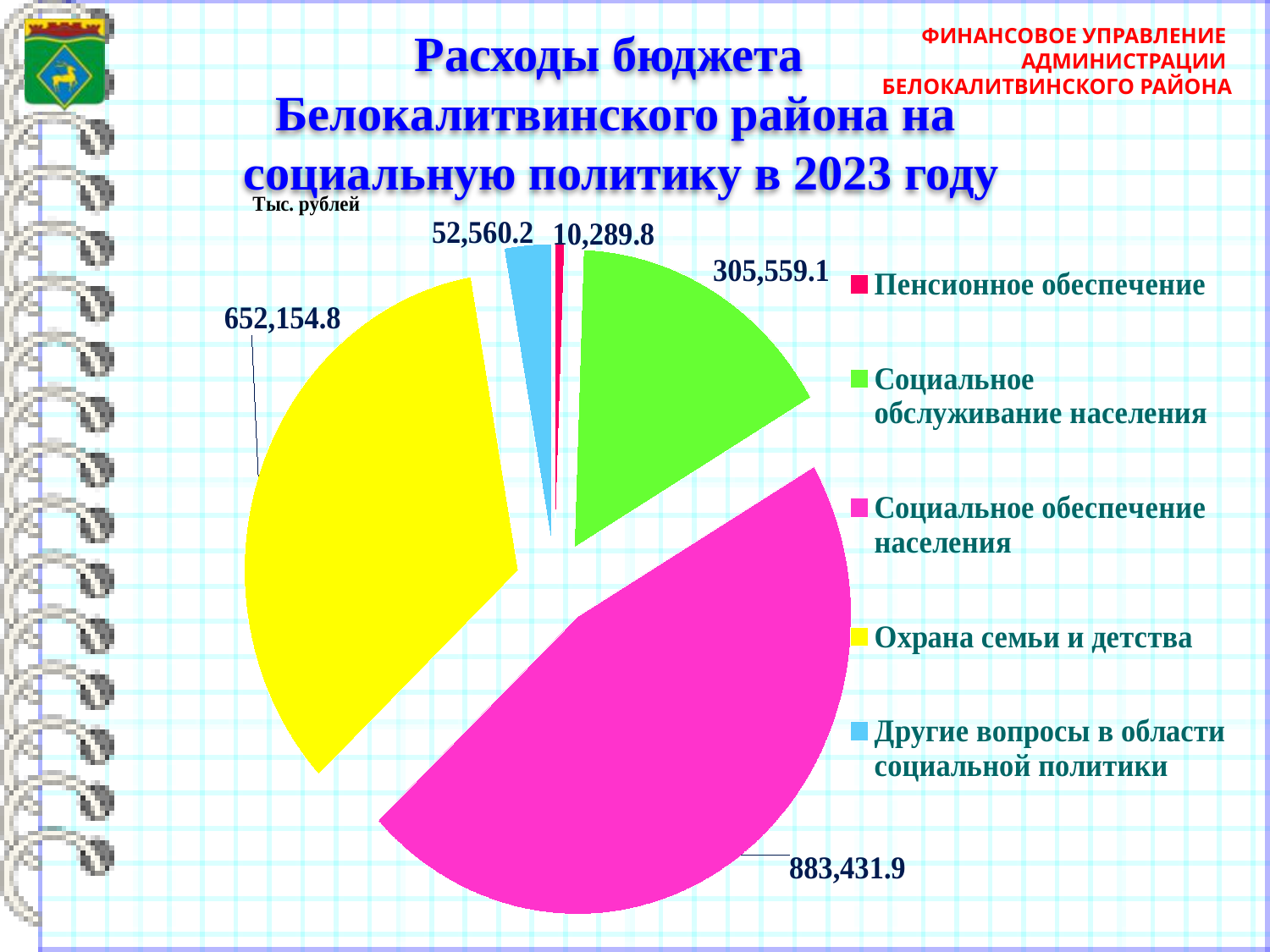
What is the value for Социальное обеспечение населения? 883,431.9 Which is larger: Социальное обслуживание населения or Другие вопросы в области социальной политики? Социальное обслуживание населения What is the value for Охрана семьи и детства? 652,154.8 Which category has the smallest slice of the pie? Пенсионное обеспечение How many entries does the legend list? 5 What unit is stated for the values in the chart? Тыс. рублей What is the difference between the values for Социальное обеспечение населения and Охрана семьи и детства? 231,277.1 What type of chart is shown on the slide? pie chart How many slices does the pie chart have? 5 What is the value for Социальное обслуживание населения? 305,559.1 Which category has the largest slice of the pie? Социальное обеспечение населения What is the value for Пенсионное обеспечение? 10,289.8